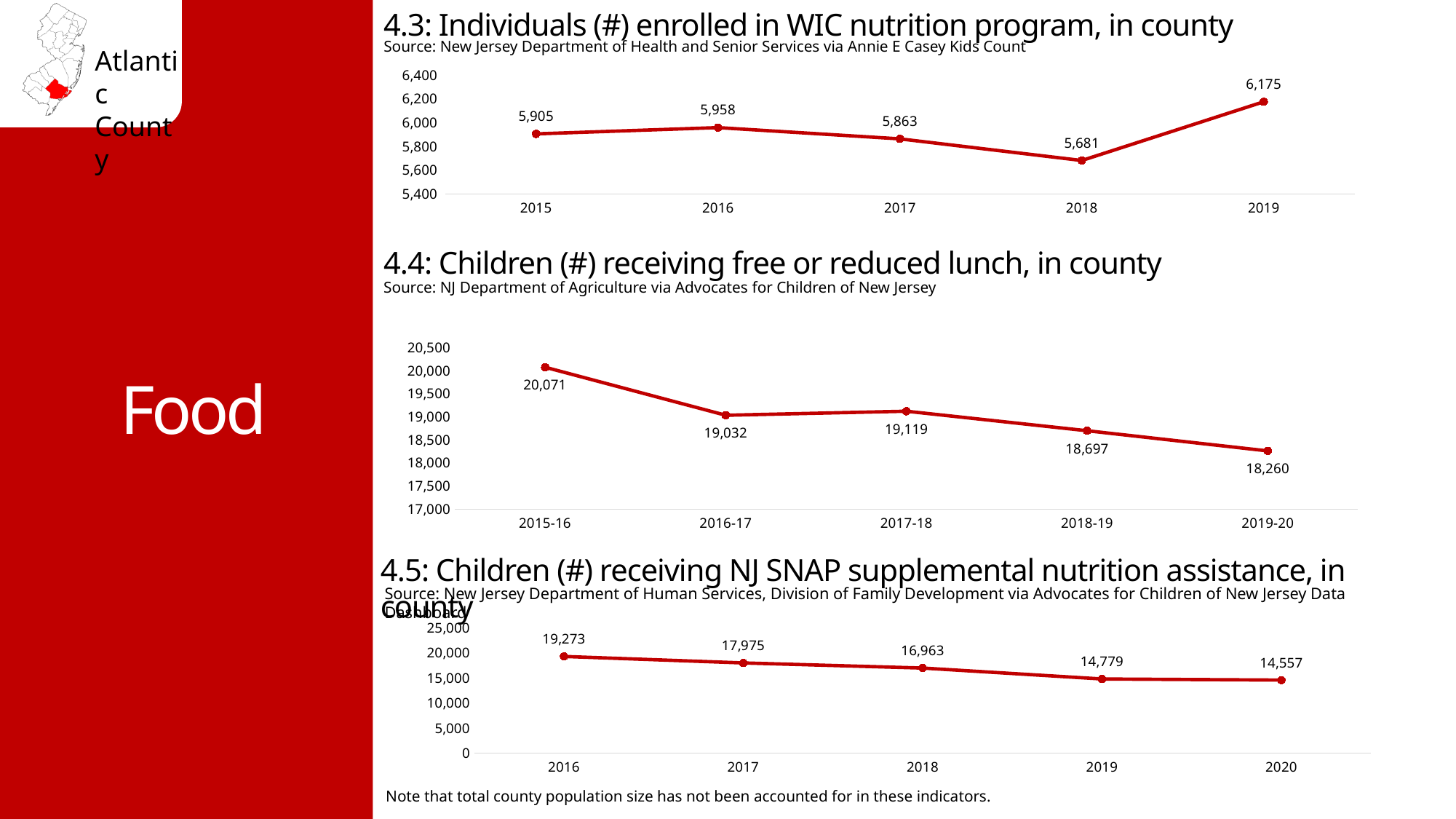
In the chart '4.3: Individuals (#) enrolled in WIC nutrition program, in county', how many data points are plotted? 5 In the chart '4.5: Children (#) receiving NJ SNAP supplemental nutrition assistance, in county', what is the value for 2020? 14,557 In the chart '4.4: Children (#) receiving free or reduced lunch, in county', what is the value for 2017-18? 19,119 In the chart '4.3: Individuals (#) enrolled in WIC nutrition program, in county', what is the value for 2018? 5,681 What type of chart is '4.5: Children (#) receiving NJ SNAP supplemental nutrition assistance, in county'? line chart In the chart '4.4: Children (#) receiving free or reduced lunch, in county', do values generally rise or fall from 2015-16 to 2019-20? fall In the chart '4.5: Children (#) receiving NJ SNAP supplemental nutrition assistance, in county', which is larger, the value for 2017 or the value for 2018? 2017 In the chart '4.4: Children (#) receiving free or reduced lunch, in county', which school year has the lowest value? 2019-20 In the chart '4.5: Children (#) receiving NJ SNAP supplemental nutrition assistance, in county', is the value for 2019 greater or less than 15,000? less In the chart '4.3: Individuals (#) enrolled in WIC nutrition program, in county', which year has the highest value? 2019 In the chart '4.4: Children (#) receiving free or reduced lunch, in county', what is the difference between the 2015-16 and 2016-17 values? 1,039 In the chart '4.3: Individuals (#) enrolled in WIC nutrition program, in county', what is the difference between the 2019 and 2018 values? 494